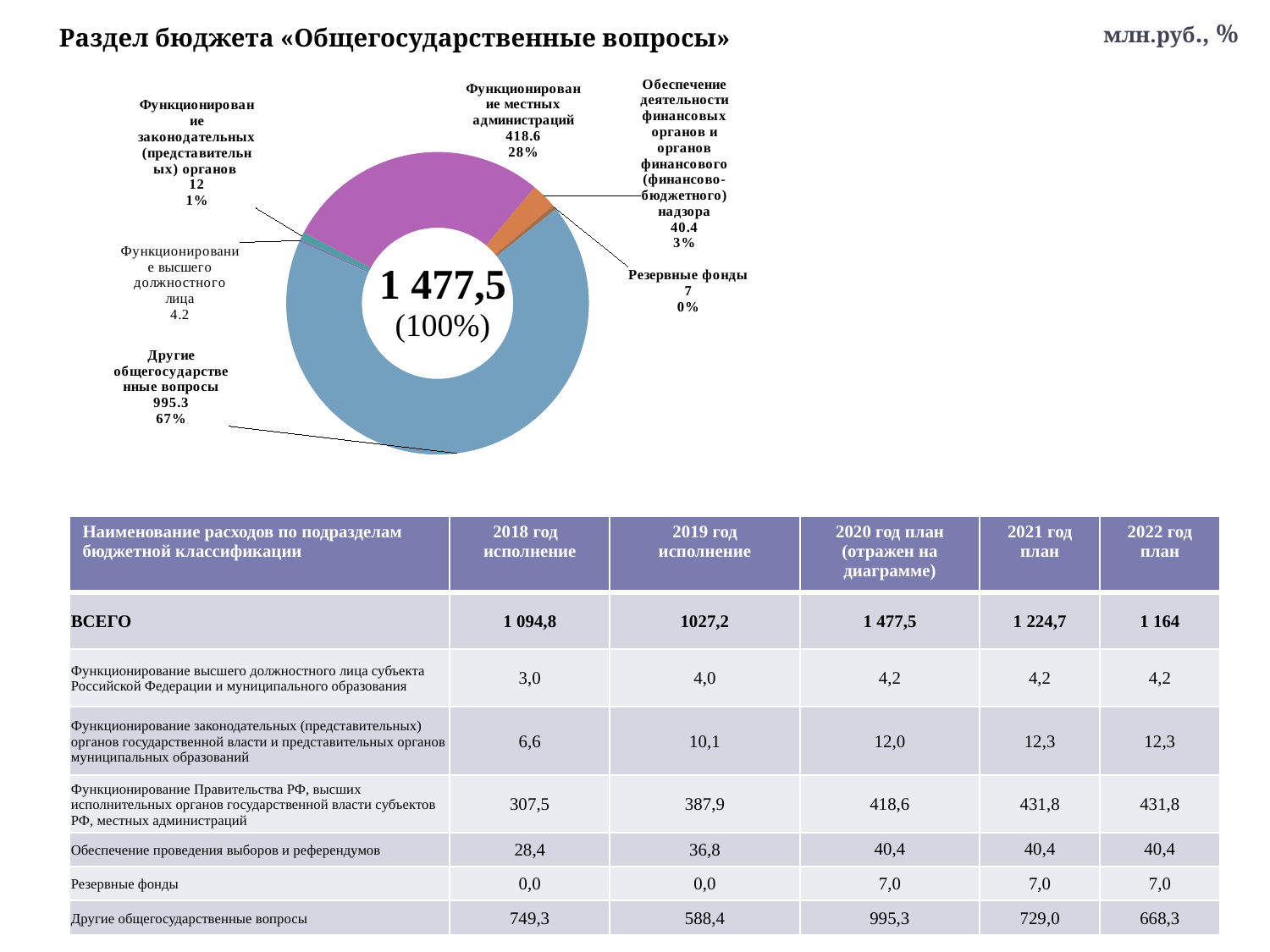
What value is shown for «Функционирование местных администраций» on the chart? 418.6 Which category has the smallest slice on the chart? Функционирование высшего должностного лица Which category has the largest slice on the chart? Другие общегосударственные вопросы What percentage share does «Функционирование местных администраций» have on the chart? 28% What kind of chart is shown on the slide? doughnut chart Which is larger on the chart: «Обеспечение деятельности финансовых органов...» or «Функционирование законодательных (представительных) органов»? Обеспечение деятельности финансовых органов What value is shown for «Резервные фонды» on the chart? 7 What is the difference between the values for «Другие общегосударственные вопросы» and «Функционирование местных администраций» on the chart? 576.7 What value is shown for «Функционирование высшего должностного лица» on the chart? 4.2 What percentage share does «Другие общегосударственные вопросы» have on the chart? 67% What total is shown in the centre of the doughnut chart? 1 477,5 (100%) What value is shown for «Другие общегосударственные вопросы» on the chart? 995.3